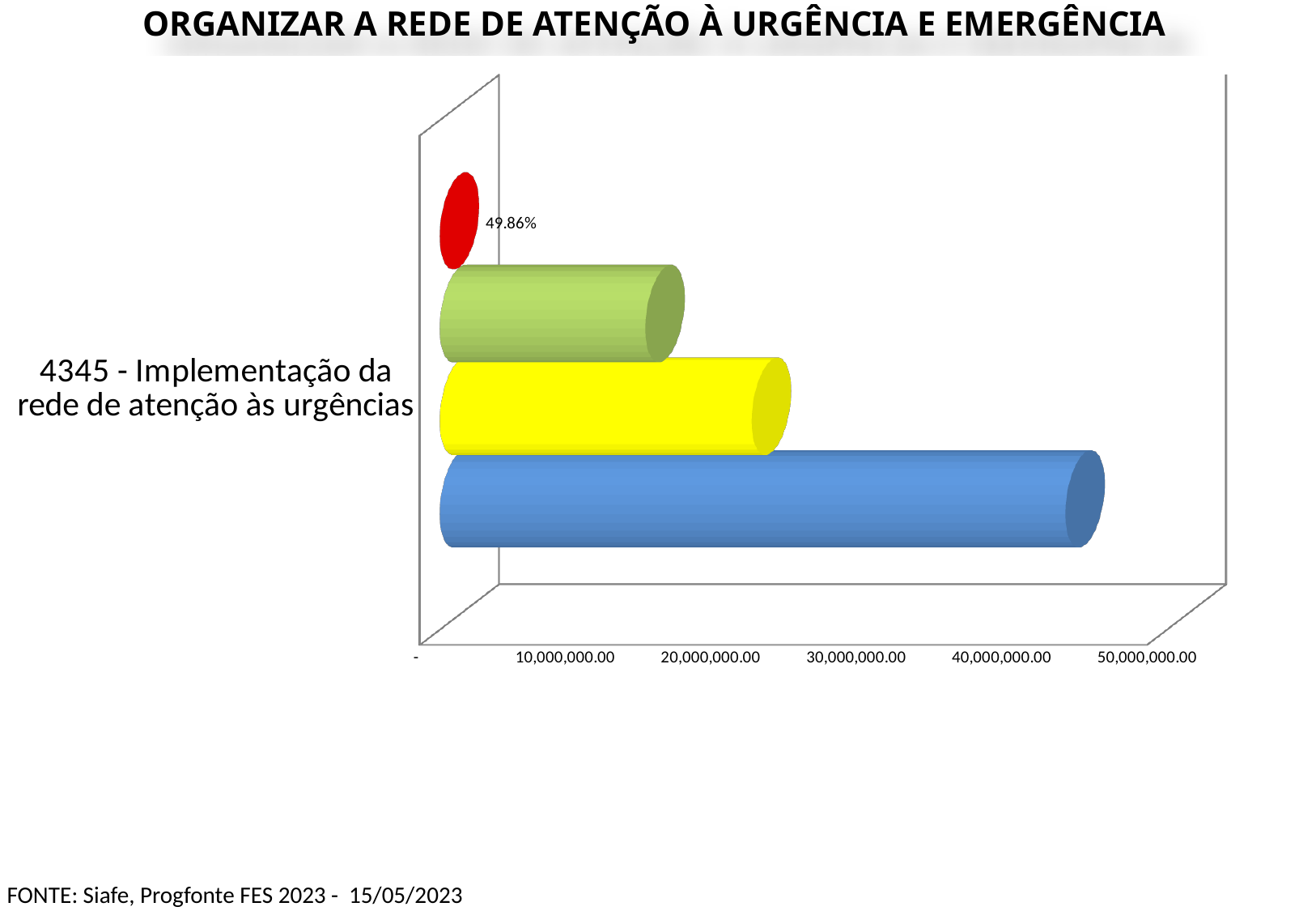
Which coloured bar is the longest in the chart? blue What kind of chart is shown on the slide? bar chart What is the category label shown on the chart? 4345 - Implementação da rede de atenção às urgências Which is larger, the yellow bar or the green bar? yellow What data label is printed next to the red bar? 49.86% Is the value of the green bar greater or less than 20,000,000.00? less How many bars are plotted for the category "4345 - Implementação da rede de atenção às urgências"? 4 How many categories are shown on the vertical axis of the chart? 1 Is the value of the blue bar greater or less than 30,000,000.00? greater Which coloured bar is the shortest in the chart? red Is the value of the yellow bar greater or less than 30,000,000.00? less What is the title of the slide above the chart? ORGANIZAR A REDE DE ATENÇÃO À URGÊNCIA E EMERGÊNCIA